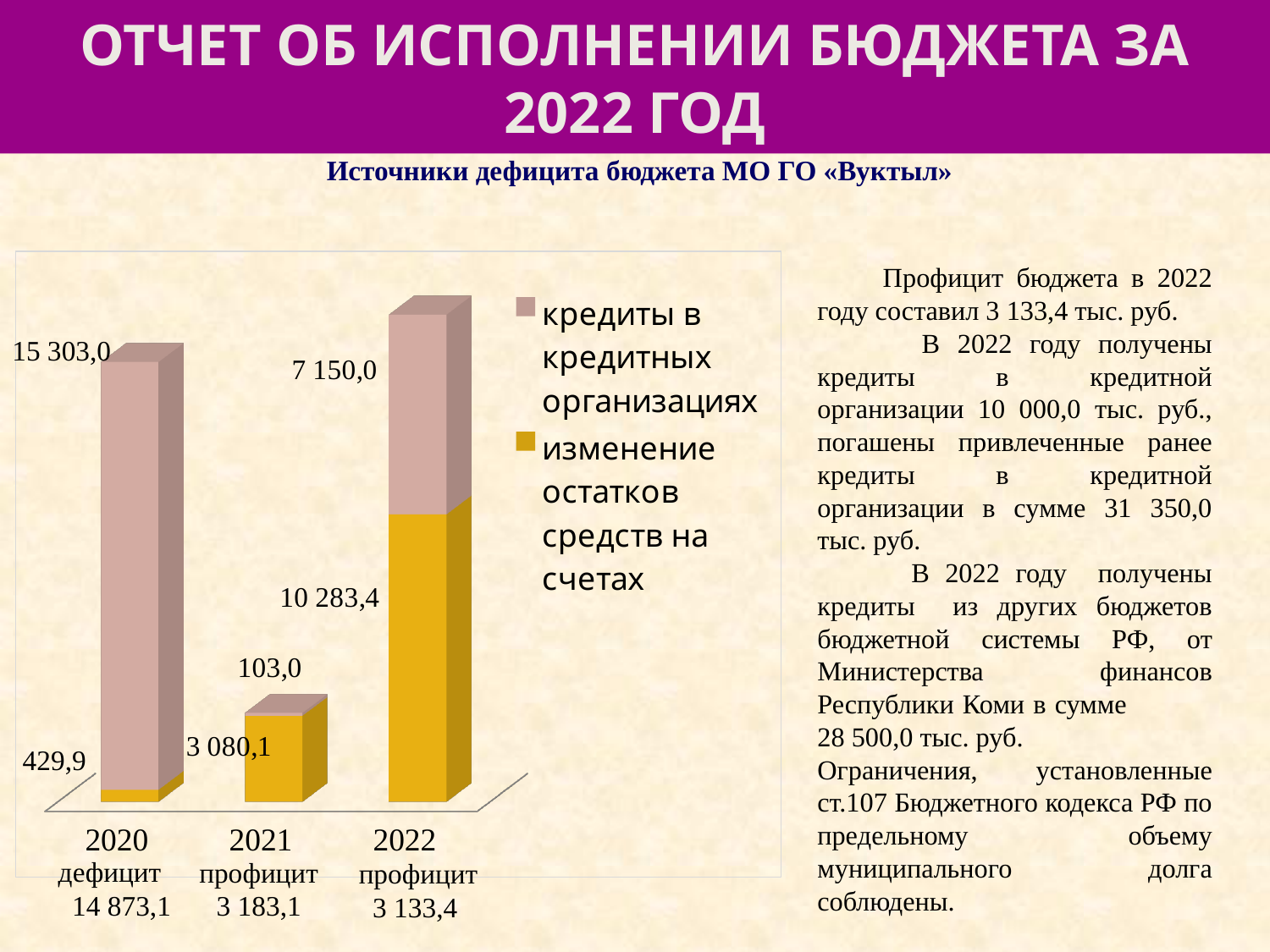
What is the value of «изменение остатков средств на счетах» for 2020? 429,9 What is the value of «кредиты в кредитных организациях» for 2021? 103,0 What is the value of «кредиты в кредитных организациях» for 2020? 15 303,0 In which year is «кредиты в кредитных организациях» the highest? 2020 In which year is «изменение остатков средств на счетах» the lowest? 2020 How many series does the chart legend list? 2 What is the title of the chart? Источники дефицита бюджета МО ГО «Вуктыл» How many year categories are plotted on the chart? 3 What type of chart is shown on the slide? Stacked bar chart What is the value of «изменение остатков средств на счетах» for 2022? 10 283,4 For 2022, which is larger: «кредиты в кредитных организациях» or «изменение остатков средств на счетах»? изменение остатков средств на счетах What is the difference between «изменение остатков средств на счетах» and «кредиты в кредитных организациях» in 2022? 3 133,4